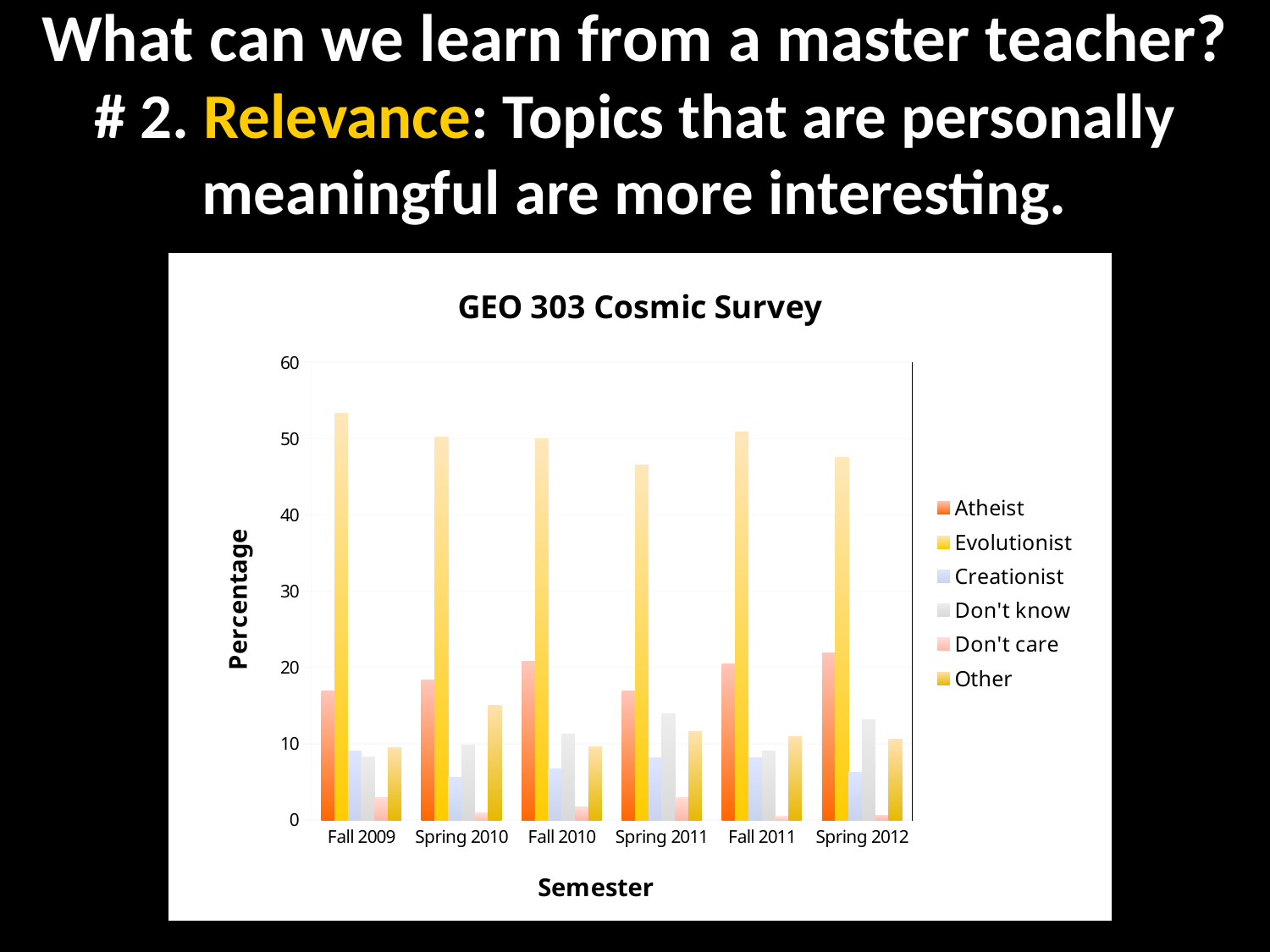
Is the Evolutionist value for Spring 2011 greater or less than 50? less Is the Evolutionist value for Fall 2009 greater or less than 50? greater How many series does the legend list? 6 Is the Atheist value for Spring 2012 greater or less than 20? greater In which semester is the Evolutionist value highest? Fall 2009 Which series has the highest value in every semester? Evolutionist Which series has the lowest value in Spring 2010? Don't care Which semester has the larger Atheist value: Fall 2010 or Spring 2011? Fall 2010 What is the title of the chart? GEO 303 Cosmic Survey In Spring 2010, which is larger: the Other value or the Don't know value? Other How many semesters are shown on the x axis? 6 What kind of chart is shown on the slide? bar chart